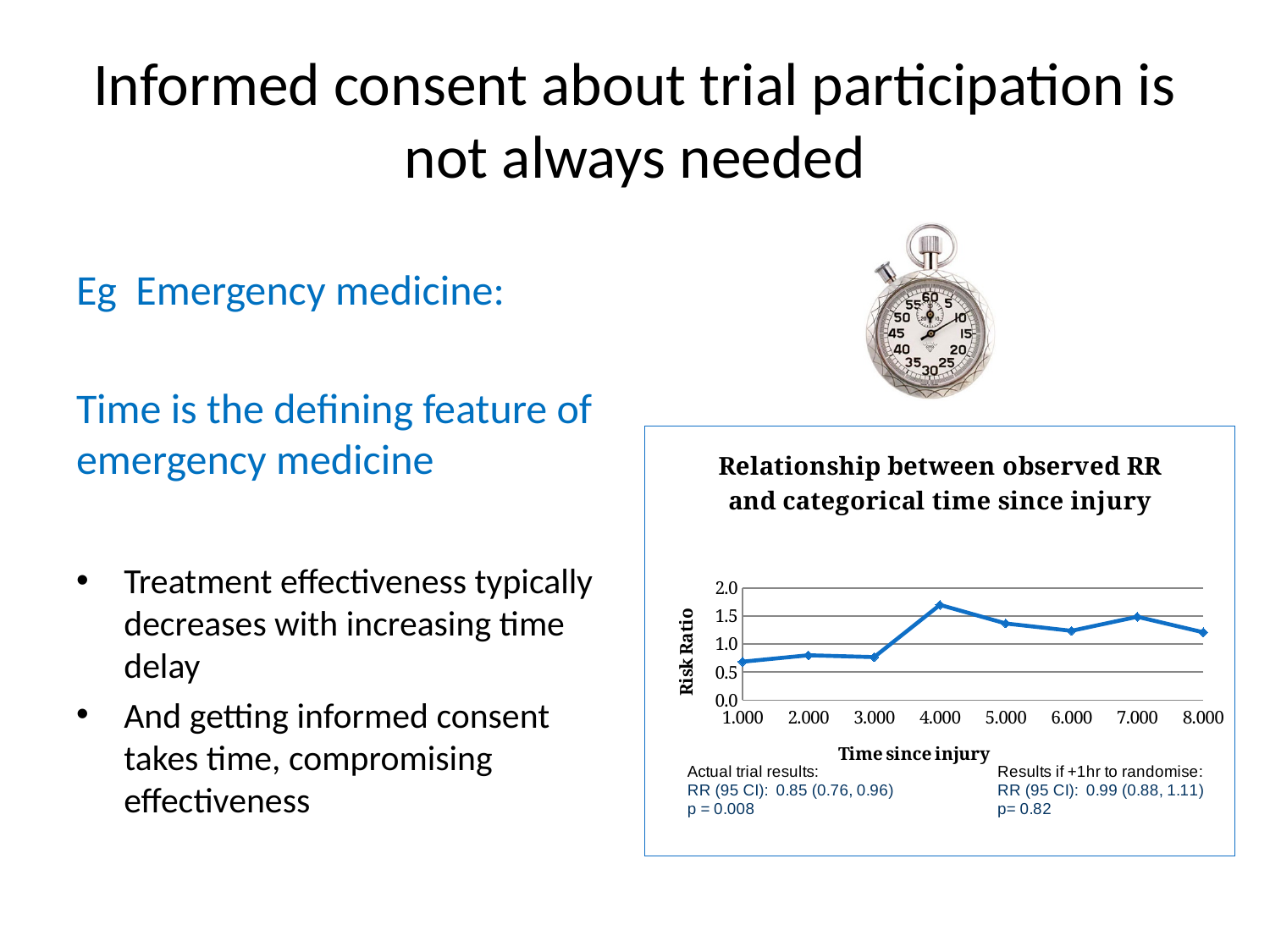
How many data points are plotted on the line in the chart? 8 Is the risk ratio at time 2.000 greater or less than 1.0? less Which has the larger risk ratio, time 4.000 or time 5.000? 4.000 What kind of chart is shown on the slide? line chart Is the risk ratio at time 4.000 greater or less than 1.5? greater Which has the larger risk ratio, time 1.000 or time 7.000? 7.000 What is the label of the vertical axis of the chart? Risk Ratio What is the title of the chart on the slide? Relationship between observed RR and categorical time since injury Is the risk ratio at time 1.000 greater or less than 1.0? less At which time since injury is the risk ratio highest? 4.000 Does the risk ratio rise or fall between time 3.000 and time 4.000? rise